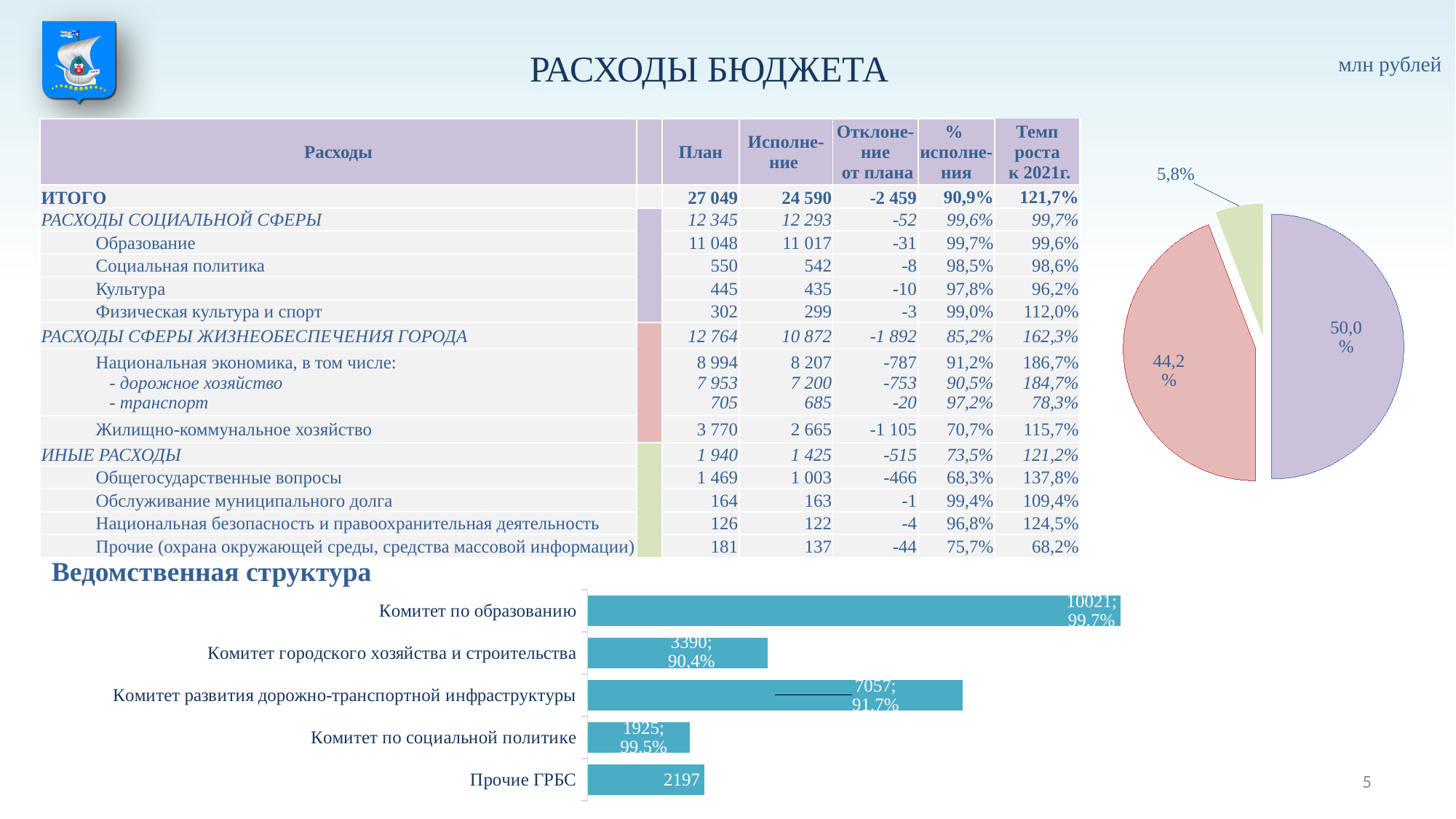
In the pie chart on the right of the slide, what share does the smallest slice show? 5,8% In the bar chart 'Ведомственная структура', what is the difference between the values for Комитет по образованию and Комитет развития дорожно-транспортной инфраструктуры? 2964 In the bar chart 'Ведомственная структура', which is larger: the value for Прочие ГРБС or the value for Комитет по социальной политике? Прочие ГРБС In the bar chart 'Ведомственная структура', what value is shown for Комитет развития дорожно-транспортной инфраструктуры? 7057 What kind of chart is the chart titled 'Ведомственная структура'? Bar chart How many categories are shown in the bar chart 'Ведомственная структура'? 5 In the bar chart 'Ведомственная структура', what percentage is shown next to the value for Комитет городского хозяйства и строительства? 90,4% In the bar chart 'Ведомственная структура', what value is shown for Комитет по образованию? 10021 In the bar chart 'Ведомственная структура', which category has the highest value? Комитет по образованию In the bar chart 'Ведомственная структура', which category has the lowest value? Комитет по социальной политике In the bar chart 'Ведомственная структура', what value is shown for Прочие ГРБС? 2197 In the pie chart on the right of the slide, what share does the largest slice show? 50,0%